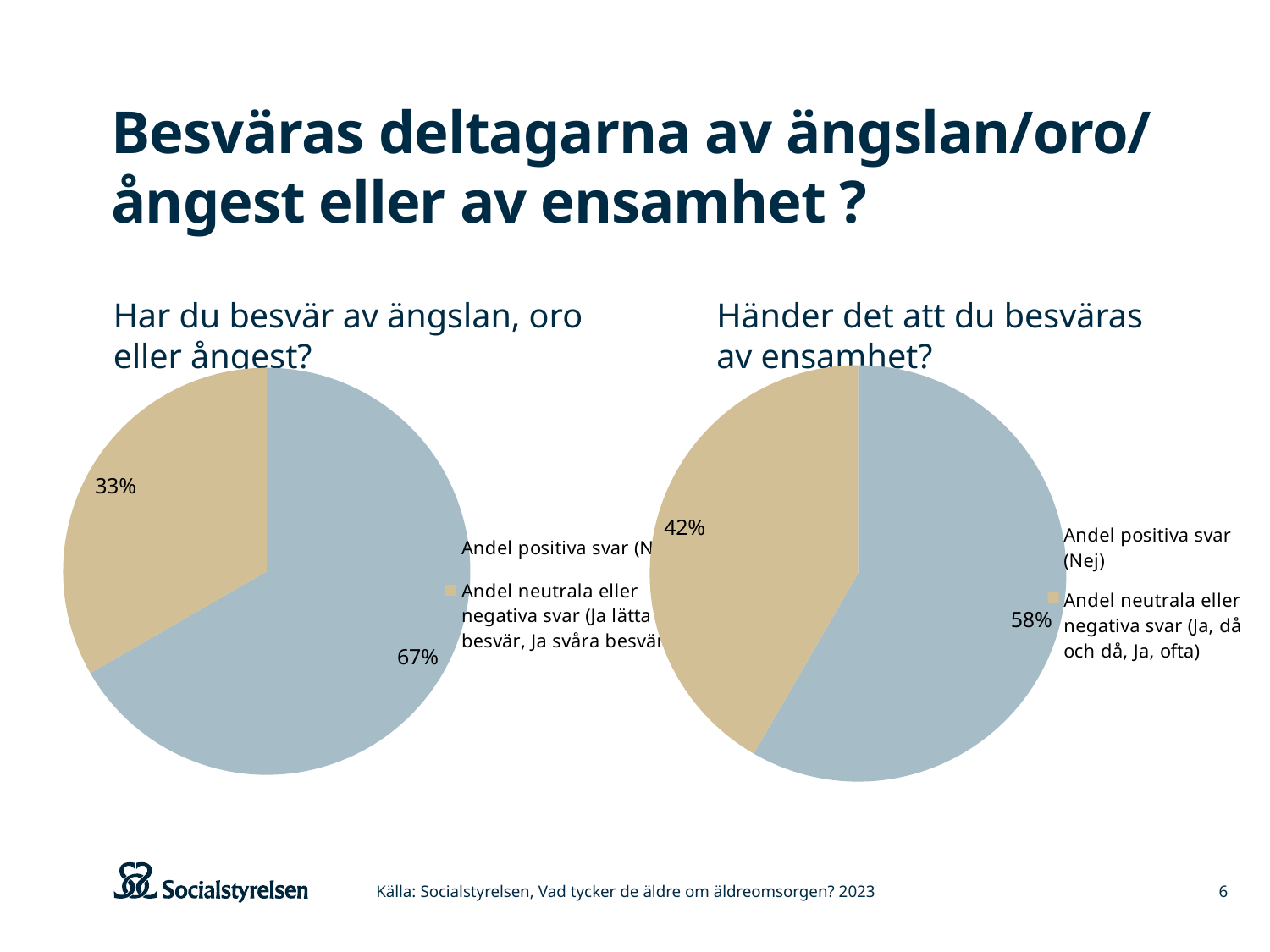
Which chart has the larger share of positive (Nej) answers, the left chart on ängslan/oro/ångest or the right chart on ensamhet? The left chart (ängslan, oro eller ångest) In the right chart 'Händer det att du besväras av ensamhet?', which slice is the smallest? Andel neutrala eller negativa svar (Ja, då och då, Ja, ofta) In the left chart 'Har du besvär av ängslan, oro eller ångest?', what is the difference in percentage points between the positive and the neutral/negative share? 34 percentage points In the right chart 'Händer det att du besväras av ensamhet?', what is the difference in percentage points between the positive and the neutral/negative share? 16 percentage points In the left chart 'Har du besvär av ängslan, oro eller ångest?', which slice is the largest? Andel positiva svar (Nej) In the right chart 'Händer det att du besväras av ensamhet?', what share of answers are neutral or negative? 42% In the right chart 'Händer det att du besväras av ensamhet?', what share of answers are positive (Nej)? 58% How many slices does the right chart 'Händer det att du besväras av ensamhet?' have? 2 In the left chart 'Har du besvär av ängslan, oro eller ångest?', what share of answers are neutral or negative? 33% What type of chart is used on this slide? Pie chart How many entries does the legend of the right chart 'Händer det att du besväras av ensamhet?' list? 2 In the left chart 'Har du besvär av ängslan, oro eller ångest?', what share of answers are positive (Nej)? 67%